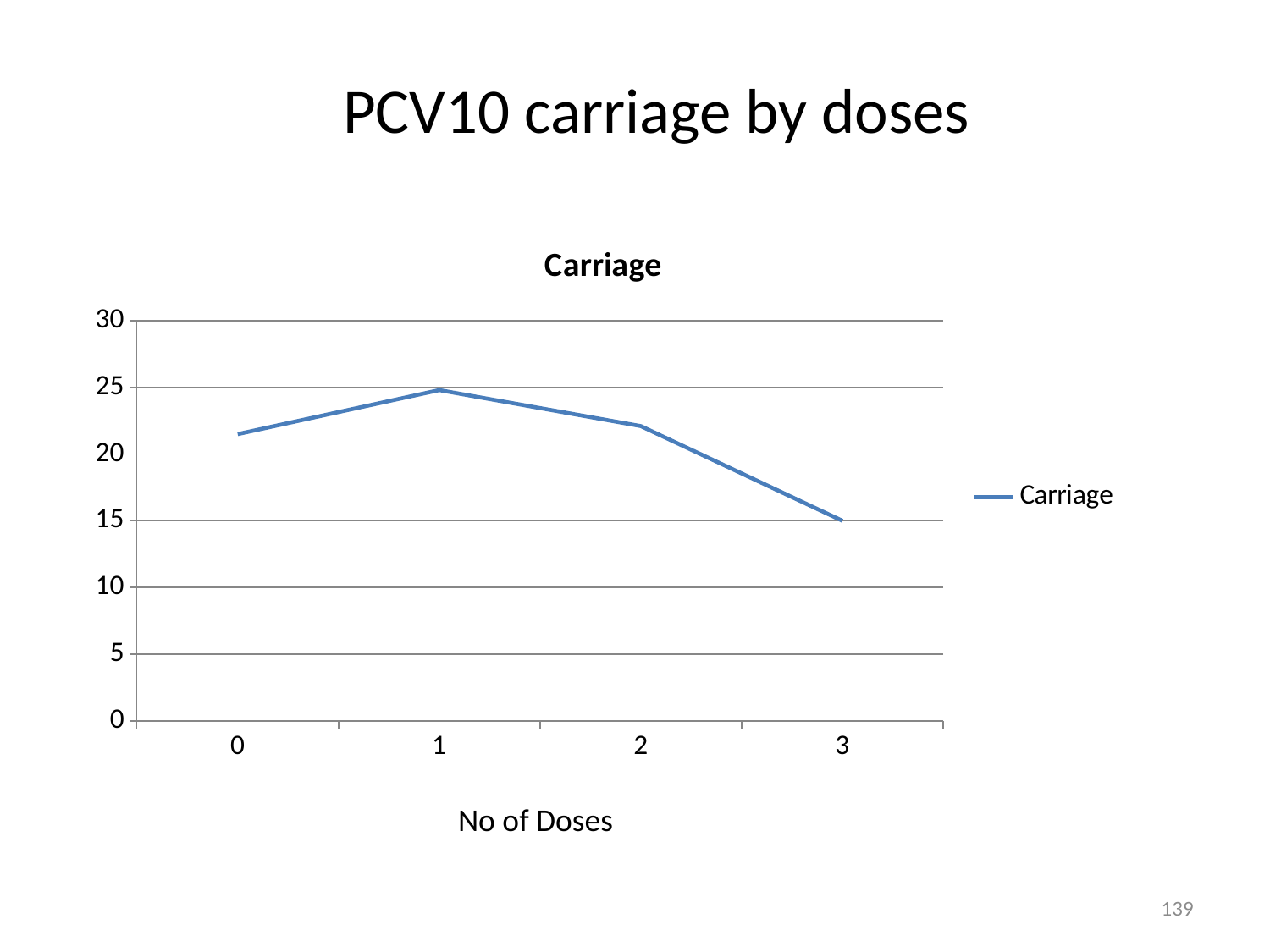
How many data points are plotted on the Carriage line? 4 Which has the higher carriage value, 1 dose or 3 doses? 1 dose At which number of doses is carriage highest? 1 How many series does the legend list? 1 Does carriage rise or fall from 1 dose to 3 doses? fall Is the carriage value at 2 doses greater or less than 20? greater At which number of doses is carriage lowest? 3 Is the carriage value at 0 doses greater or less than 20? greater What is the label on the x axis of the chart? No of Doses What is the carriage value at 3 doses? 15 What kind of chart is shown on the slide? line chart